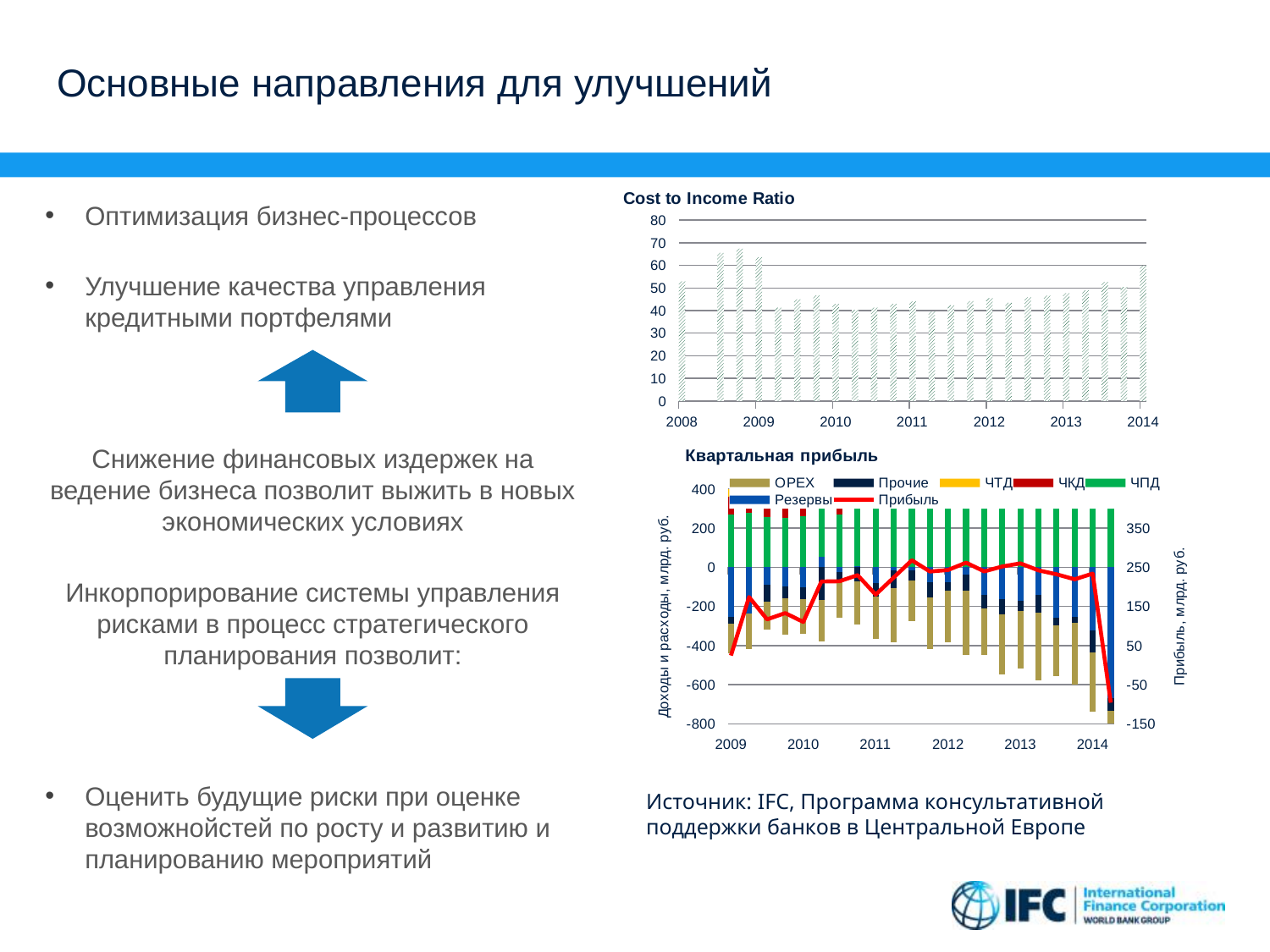
In the "Cost to Income Ratio" chart, is the last bar (2014) greater or less than 40? greater In the "Квартальная прибыль" chart, does the Прибыль line end higher or lower than it starts? lower What kind of chart is the "Квартальная прибыль" chart? stacked bar chart with a line In the "Cost to Income Ratio" chart, is the highest bar greater or less than 60? greater What is the first year shown on the x axis of the "Квартальная прибыль" chart? 2009 In the "Cost to Income Ratio" chart, what is the maximum value shown on the vertical axis? 80 In the "Квартальная прибыль" chart, which series is drawn as a red line? Прибыль What kind of chart is the "Cost to Income Ratio" chart? bar chart How many series does the legend of the "Квартальная прибыль" chart list? 7 In the "Квартальная прибыль" chart, is the final value of the Прибыль line (2014) greater or less than 50 on the right axis? less